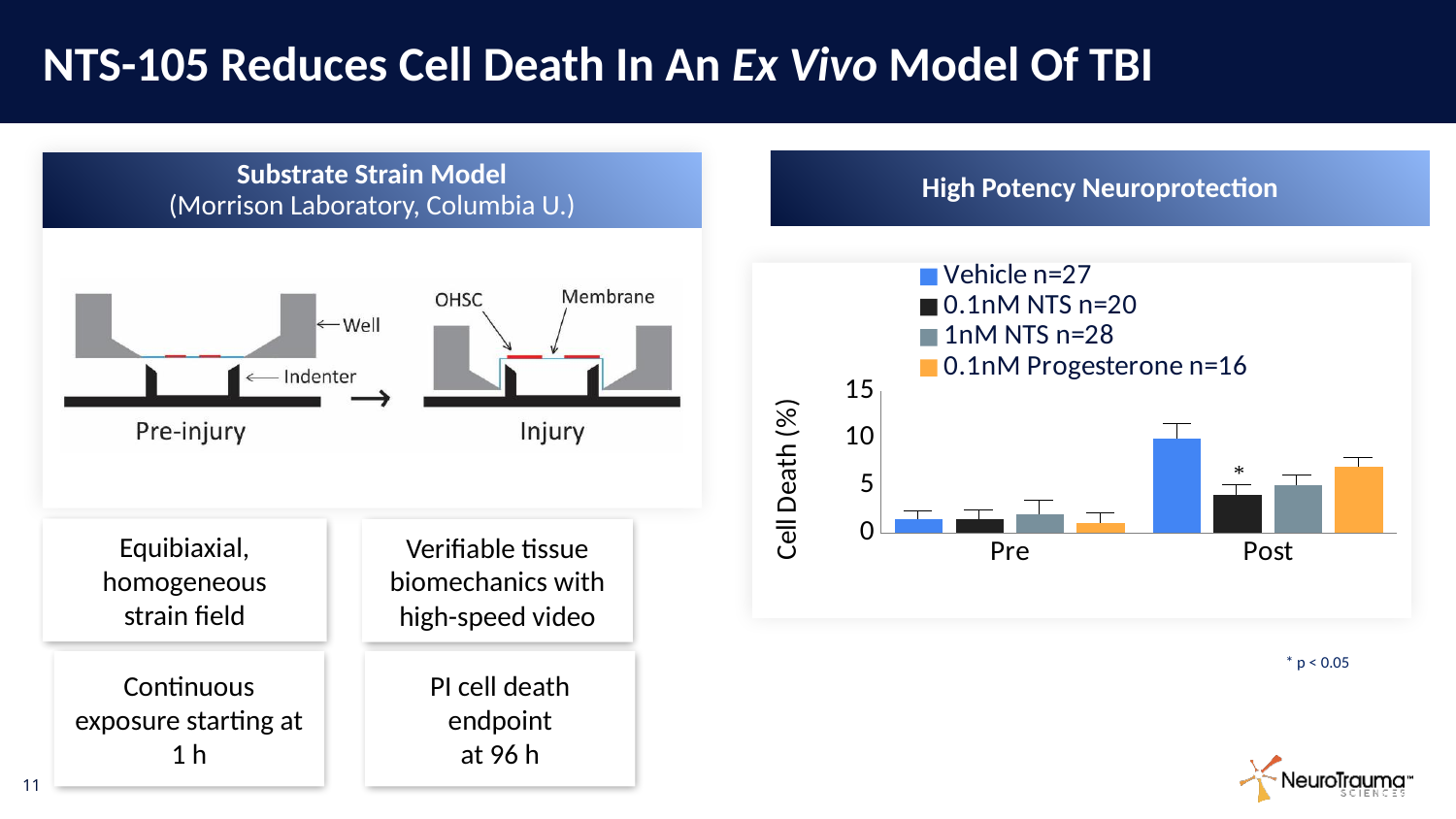
Is the Post value for Vehicle greater or less than 5? greater Is the Post value for 0.1nM NTS greater or less than 5? less Does the Vehicle series rise or fall from Pre to Post? rise What is the y-axis title of the cell death chart? Cell Death (%) In the Post category, which is larger: the Vehicle bar or the 0.1nM NTS bar? Vehicle What kind of chart is shown under the 'High Potency Neuroprotection' heading? bar chart How many series does the legend of the cell death chart list? 4 According to the legend, what is the n for the 1nM NTS series? 28 Which series has the highest cell death in the Post category? Vehicle n=27 How many categories are shown on the x axis of the cell death chart? 2 Is the Post value for 0.1nM Progesterone greater or less than 5? greater Which series has the lowest cell death in the Post category? 0.1nM NTS n=20